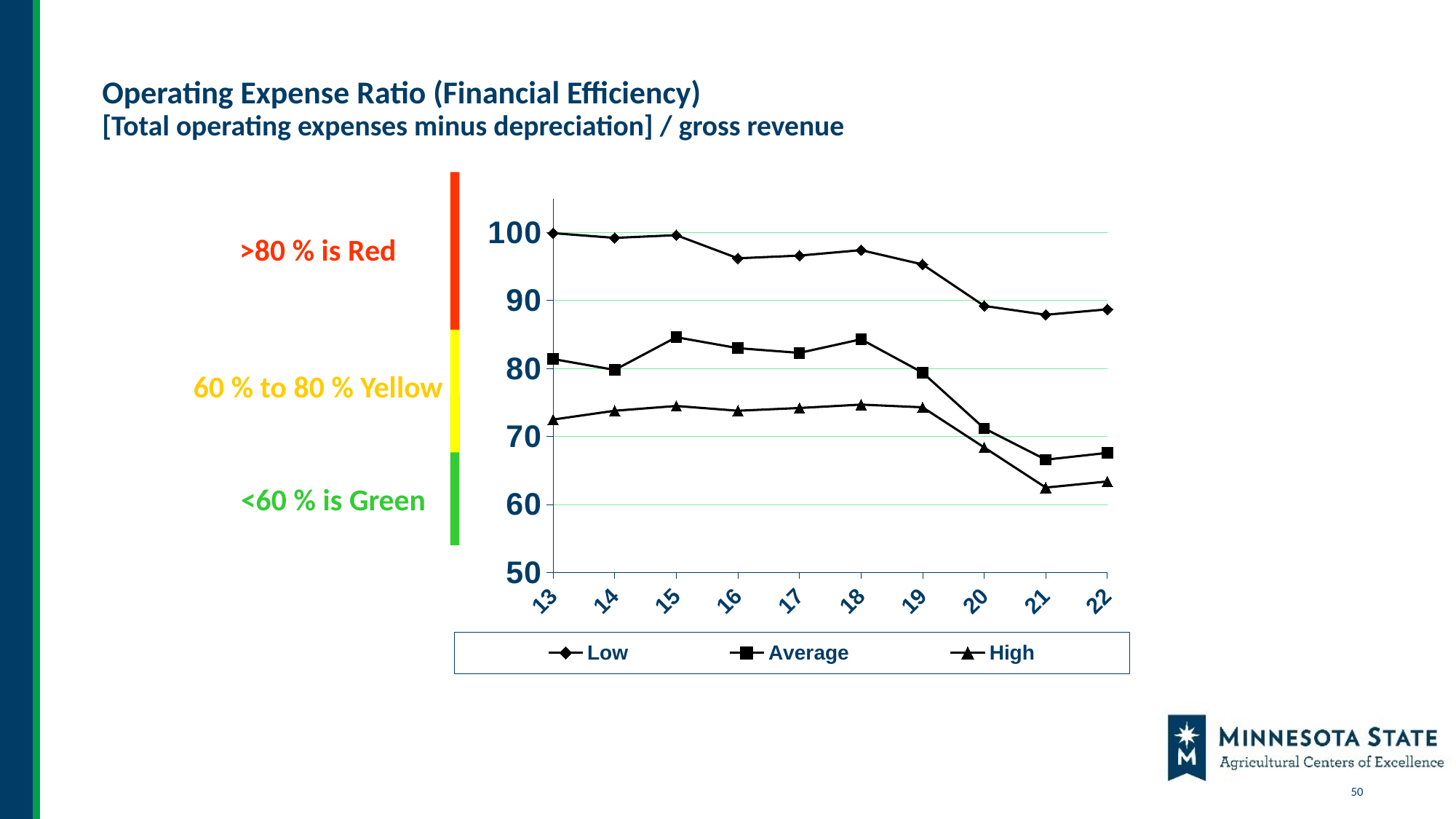
Which is larger for the Low series: the value in year 13 or the value in year 20? year 13 Is the value of the Average series in year 15 greater or less than 80? greater What kind of chart is shown on the slide? line chart According to the colour scale on the slide, what colour is an operating expense ratio above 80%? Red Is the value of the Low series in year 22 greater or less than 90? less How many series does the legend list? 3 Is the value of the Average series in year 21 greater or less than 70? less How many years are plotted along the x axis? 10 Does the Average series generally rise or fall from year 13 to year 22? fall Which series has the highest values across the chart? Low